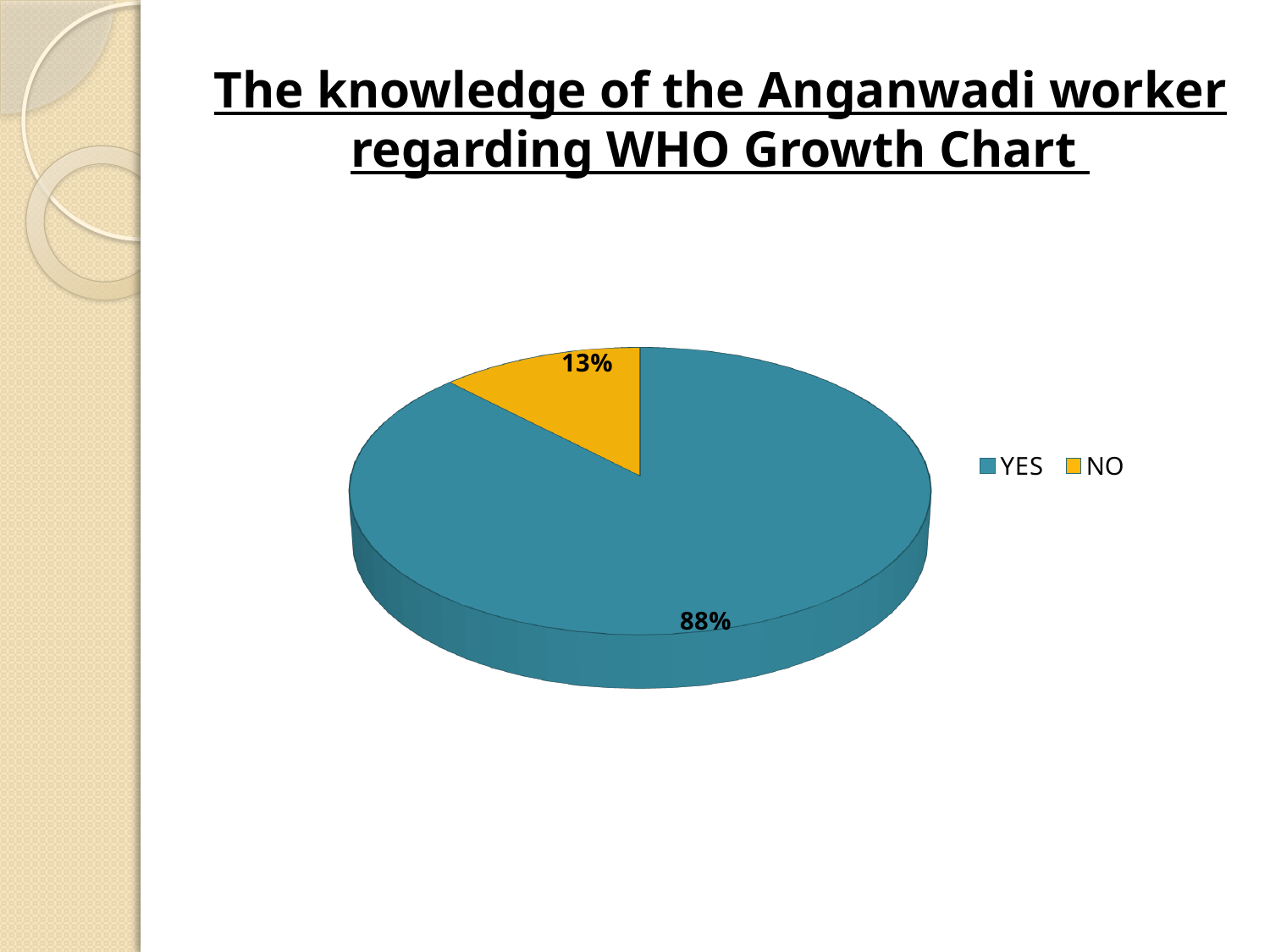
Which category has the smallest slice of the pie chart? NO What percentage of the pie chart is labelled YES? 88% How many entries does the legend list? 2 Which category has the largest slice of the pie chart? YES What is the title of the slide containing the pie chart? The knowledge of the Anganwadi worker regarding WHO Growth Chart What share of the pie does the NO slice represent? 13% What kind of chart is shown on the slide? Pie chart What colour is the YES slice in the pie chart? Teal blue What is the difference in percentage points between the YES and NO slices? 75 What percentage of the pie chart is labelled NO? 13% Which slice is larger, YES or NO? YES How many slices does the pie chart have? 2